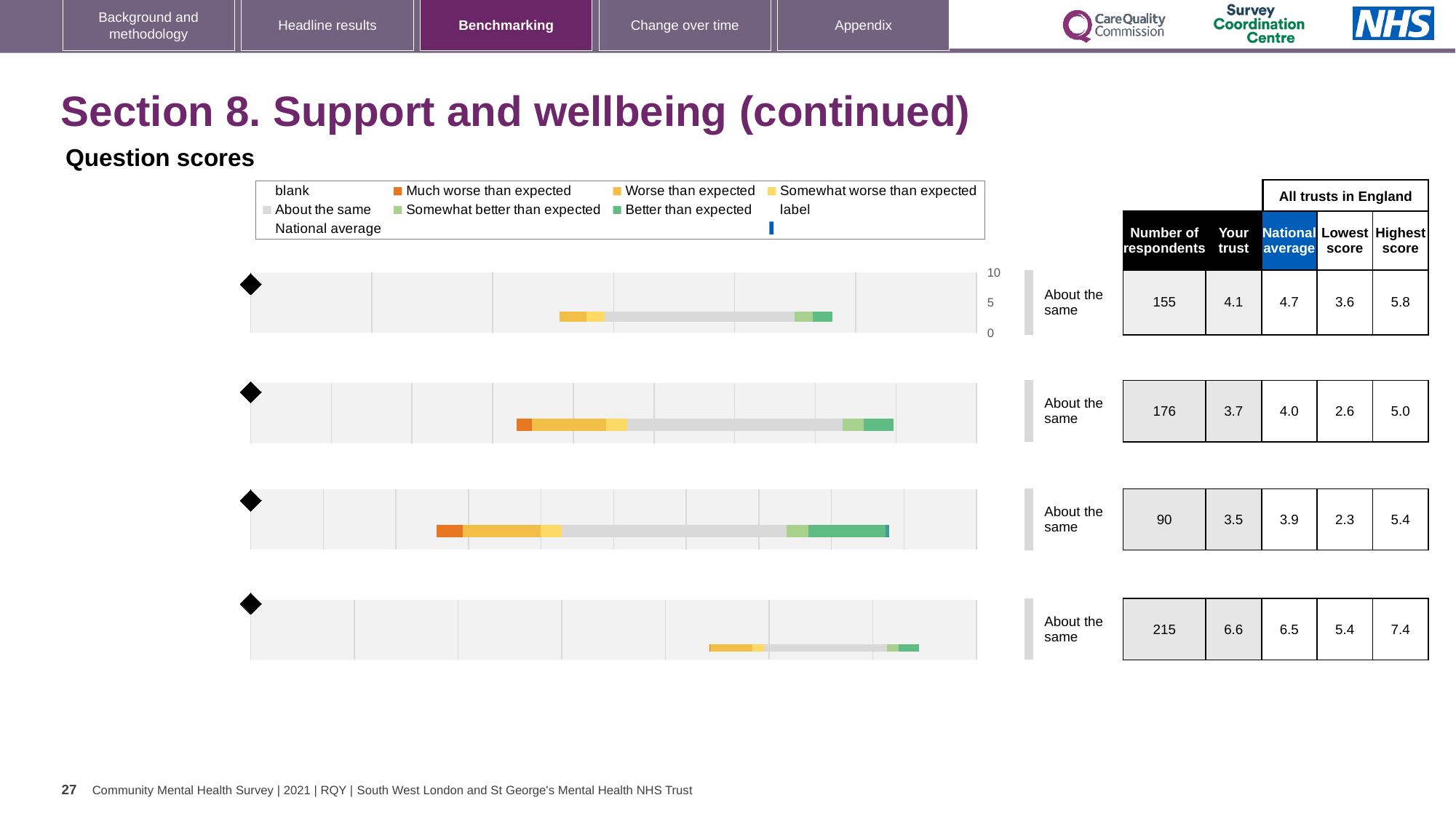
How many benchmarking bar charts are shown on the slide? 4 Which legend entry is shown in orange on the benchmarking charts? Much worse than expected For the top benchmarking chart row, what is the difference between the highest score (5.8) and the lowest score (3.6)? 2.2 For the top benchmarking chart row, what is the 'Your trust' score shown in the table? 4.1 For the second benchmarking chart row, what is the national average shown in the table? 4.0 What is the maximum value shown on the axis of the top benchmarking chart? 10 Which benchmarking chart row has the lowest 'Your trust' score? the third row (3.5) For the third benchmarking chart row, how many respondents are shown in the table? 90 For the bottom benchmarking chart row, which is larger: the 'Your trust' score or the national average? Your trust (6.6) For the bottom benchmarking chart row, what is the highest score across all trusts in England? 7.4 Which benchmarking chart row has the largest number of respondents? the bottom row (215) What kind of chart is used for the four benchmarking rows on this slide? bar chart